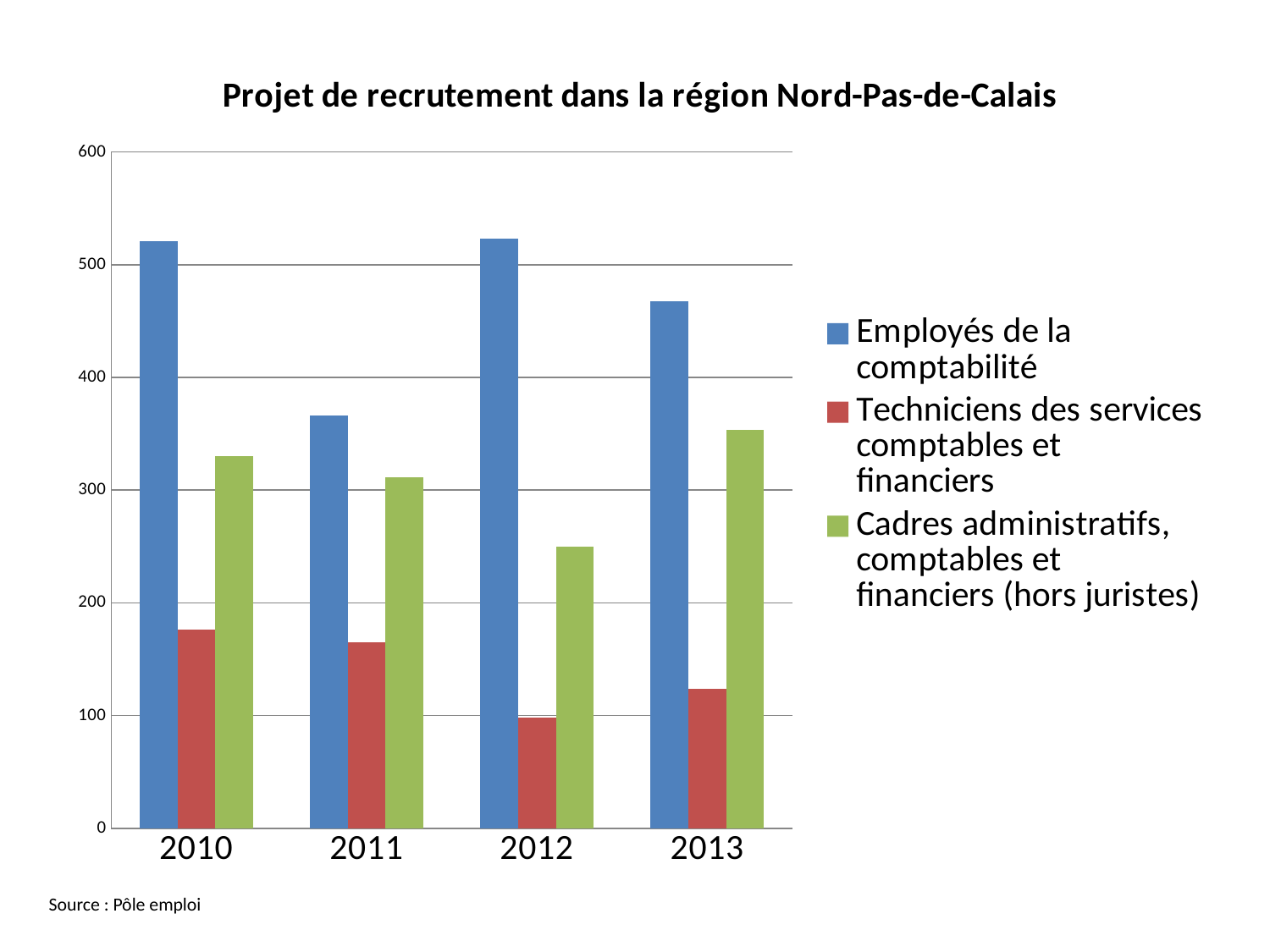
In 2010, which is larger: Techniciens des services comptables et financiers or Cadres administratifs, comptables et financiers (hors juristes)? Cadres administratifs, comptables et financiers (hors juristes) What kind of chart is shown on the slide? bar chart Is the value for Cadres administratifs, comptables et financiers (hors juristes) in 2012 greater or less than 200? greater What is the title of the chart? Projet de recrutement dans la région Nord-Pas-de-Calais In which year is the value for Cadres administratifs, comptables et financiers (hors juristes) lowest? 2012 How many series does the legend list? 3 Is the value for Employés de la comptabilité in 2011 greater or less than 400? less Is the value for Employés de la comptabilité in 2013 greater or less than 500? less In which year is the value for Techniciens des services comptables et financiers lowest? 2012 In which year is the value for Employés de la comptabilité lowest? 2011 How many years are shown on the x axis? 4 Which series is shown in green? Cadres administratifs, comptables et financiers (hors juristes)